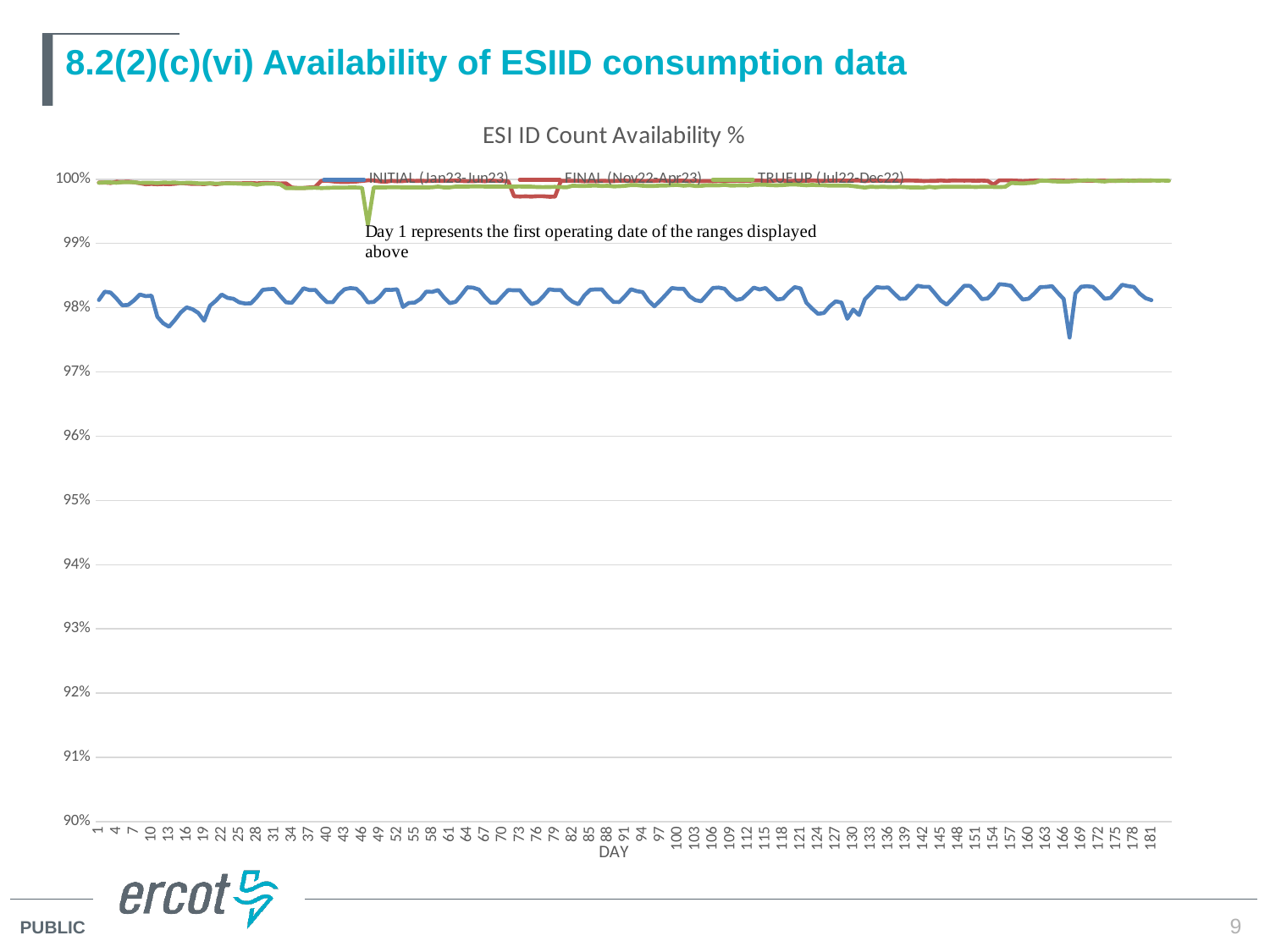
How many series does the legend list? 3 What kind of chart is shown on the slide? line chart Is the value for INITIAL (Jan23-Jun23) at day 100 greater or less than 97%? greater At day 13, which series has the lower value, INITIAL (Jan23-Jun23) or TRUEUP (Jul22-Dec22)? INITIAL (Jan23-Jun23) At day 100, which series has the higher value, INITIAL (Jan23-Jun23) or FINAL (Nov22-Apr23)? FINAL (Nov22-Apr23) What is the label of the x axis? DAY Is the value for TRUEUP (Jul22-Dec22) at day 100 greater or less than 99%? greater What is the title of the chart? ESI ID Count Availability % Is the value for FINAL (Nov22-Apr23) at day 100 greater or less than 99%? greater Which series has the lowest values across the chart? INITIAL (Jan23-Jun23)